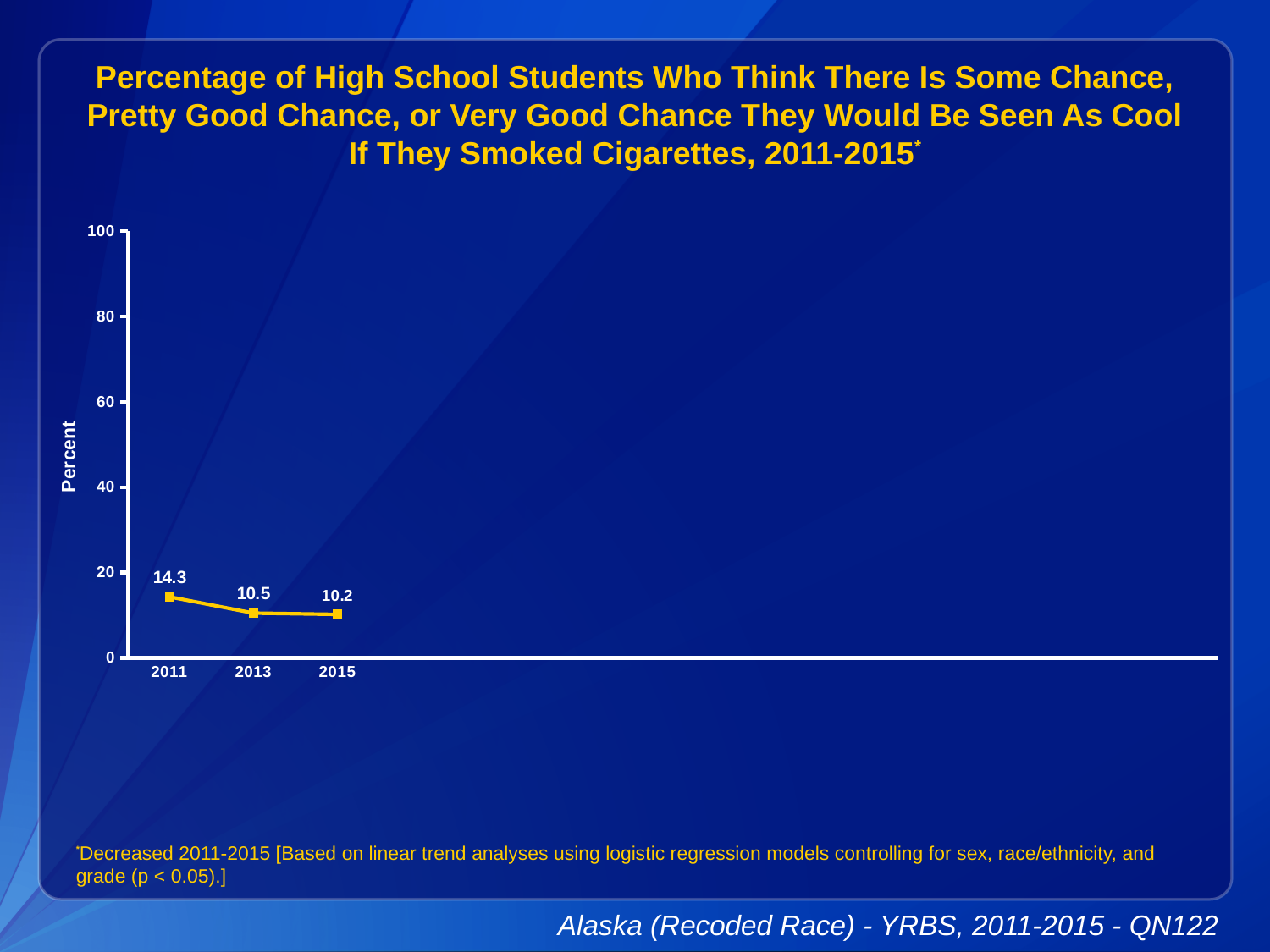
Which year has the highest value? 2011 How many years are plotted on the chart? 3 What kind of chart is shown on the slide? line chart Is the value for 2011 greater or less than 20? less Which is larger, the value for 2011 or the value for 2013? 2011 What is the difference between the values for 2011 and 2013? 3.8 Do the values rise or fall from 2011 to 2015? fall What is the value for 2015? 10.2 What is the value for 2013? 10.5 What is the difference between the values for 2011 and 2015? 4.1 Which year has the lowest value? 2015 What is the value for 2011? 14.3